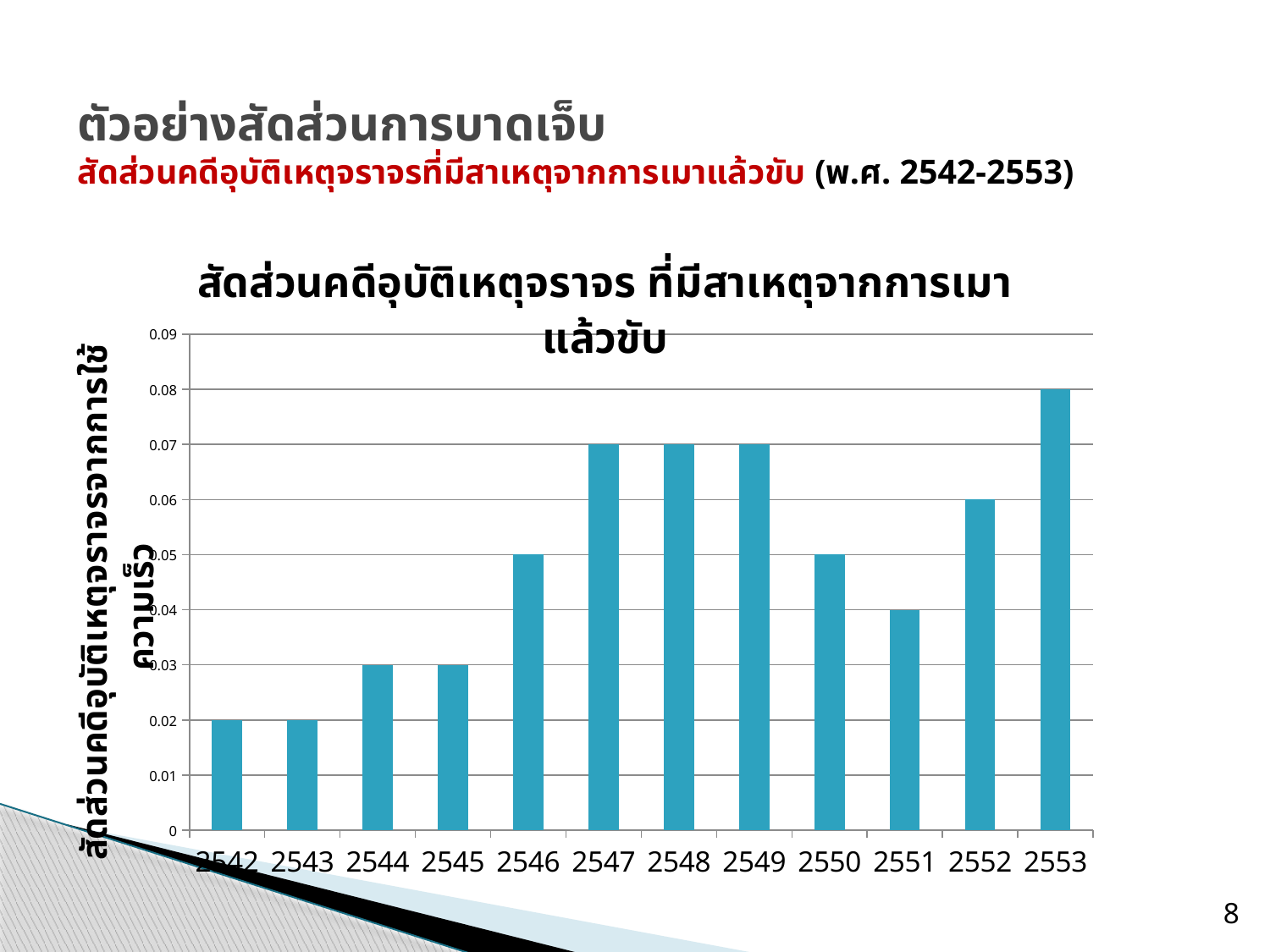
What type of chart is shown on the slide? bar chart What is the value for 2546? 0.05 What is the value for 2551? 0.04 What is the difference between the values for 2553 and 2542? 0.06 Which year has the lowest value, 2542 or 2544? 2542 How many years (bars) are plotted in the chart? 12 What is the maximum value shown on the vertical axis? 0.09 Is the value for 2545 greater or less than 0.04? less What is the value for 2553? 0.08 Do the values generally rise or fall from 2542 to 2549? rise Which year has the highest value? 2553 Is the value for 2552 greater or less than 0.05? greater